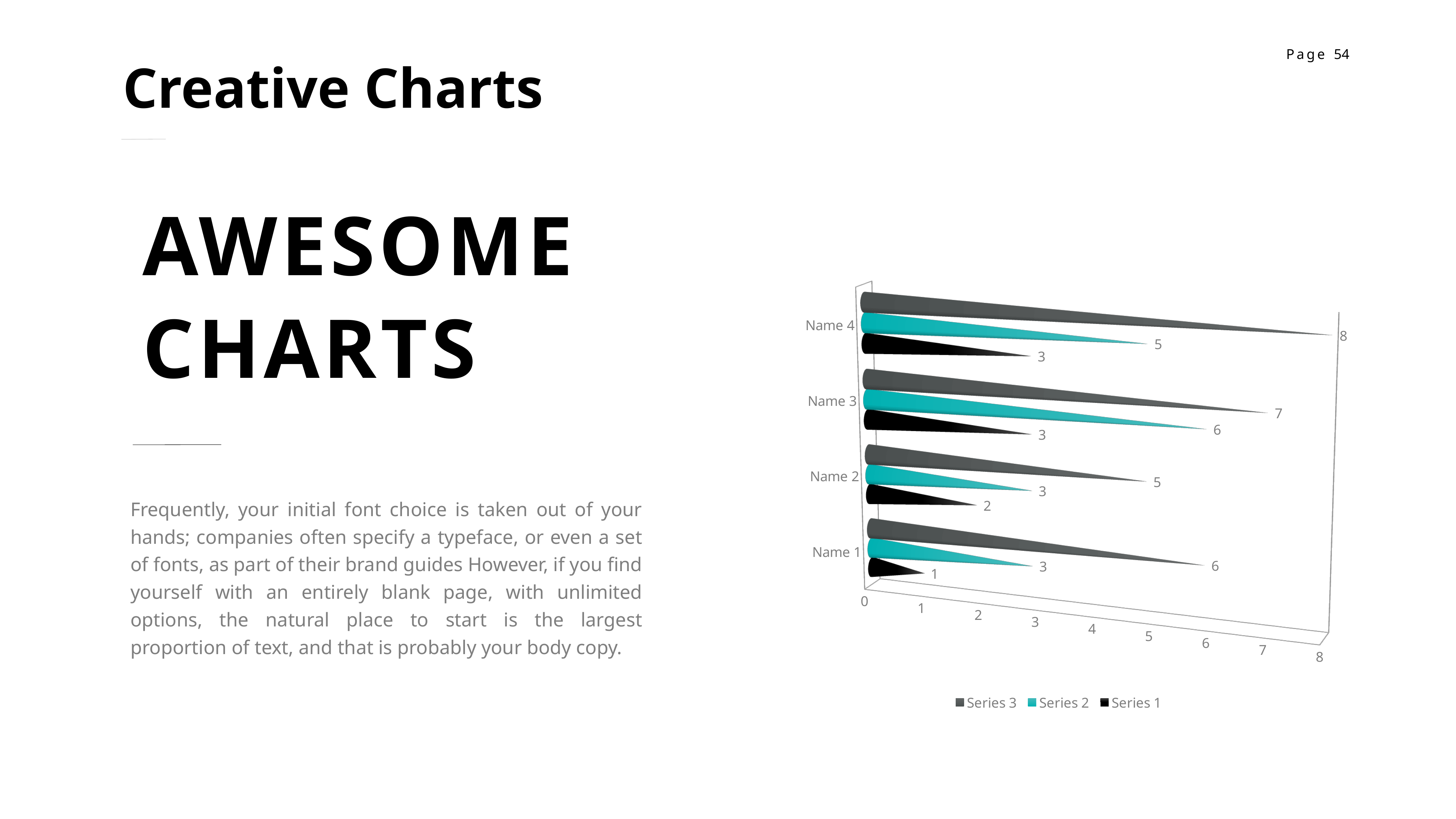
What colour represents Series 2 in the chart? Teal What is the value of Series 2 for Name 3? 6 What is the difference between the Series 3 value and the Series 1 value for Name 4? 5 How many series does the legend list? 3 How many categories are shown on the chart? 4 Which category has the lowest value for Series 1? Name 1 What is the value of Series 3 for Name 4? 8 Which category has the highest value for Series 3? Name 4 Which is larger for Name 1: the Series 3 value or the Series 2 value? Series 3 What kind of chart is shown on the slide? Bar chart What is the value of Series 1 for Name 1? 1 What is the value of Series 2 for Name 2? 3